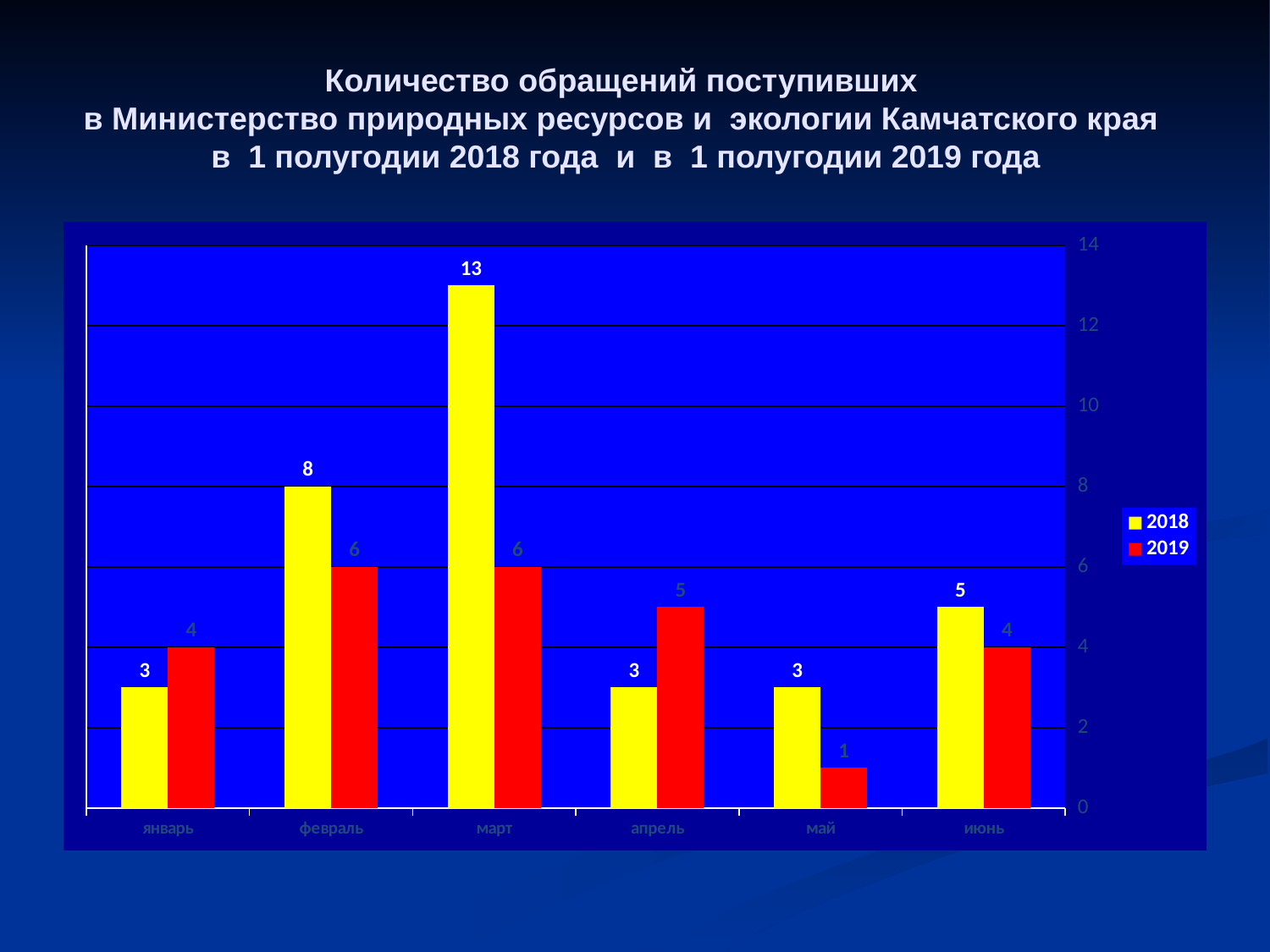
Which colour represents the 2019 series in the legend? red What is the value for март in the 2018 series? 13 What is the value for апрель in the 2019 series? 5 How many series does the legend list? 2 What type of chart is shown on the slide? bar chart Which month has the lowest value in the 2019 series? май Which is larger for апрель: the 2018 value or the 2019 value? 2019 What is the difference between the 2018 values for февраль and январь? 5 What is the difference between the 2018 and 2019 values for март? 7 Which month has the highest value in the 2018 series? март What is the value for май in the 2019 series? 1 How many months are shown on the x axis? 6